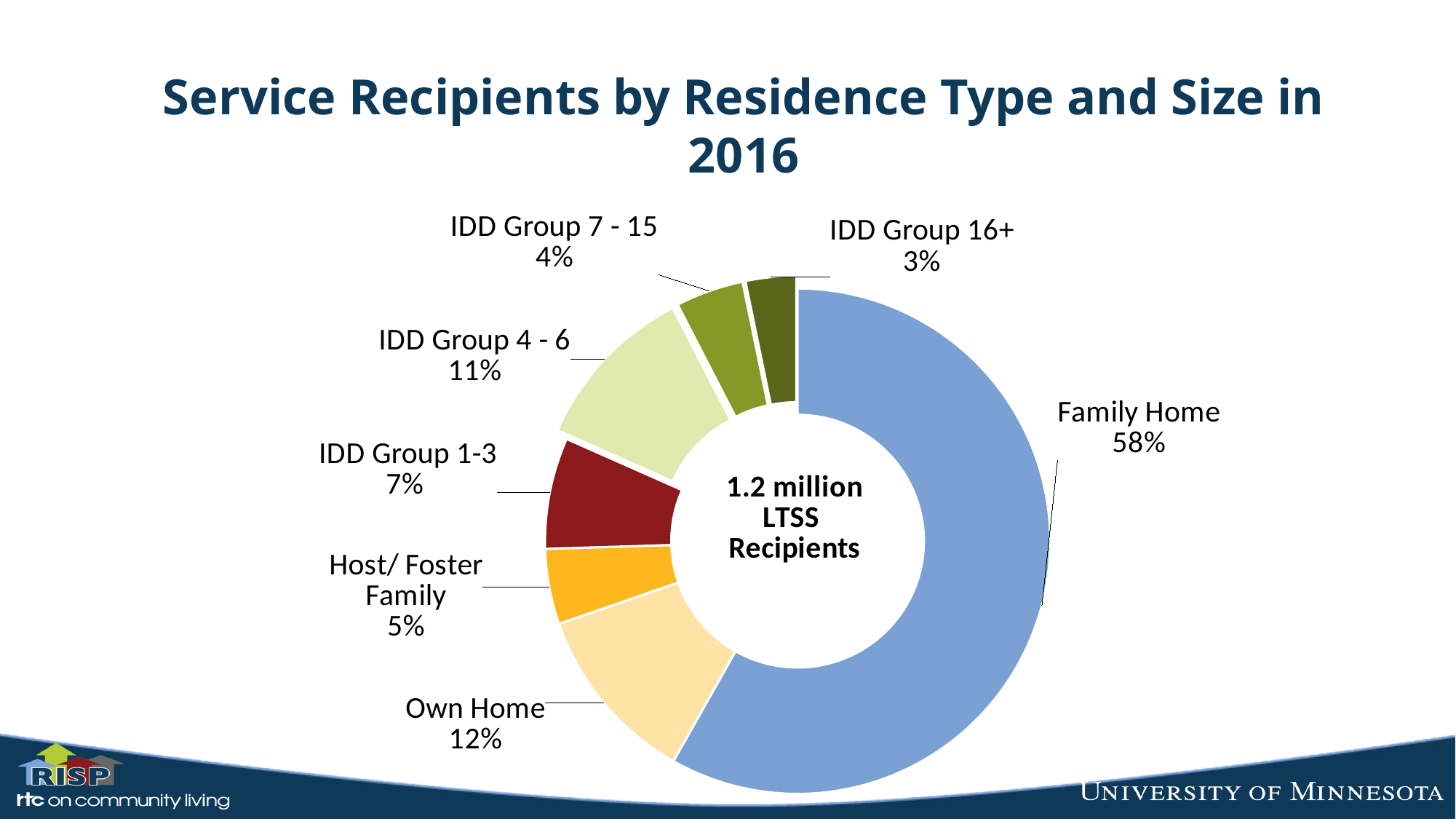
What kind of chart is shown on the slide? Pie chart (donut) What percentage of service recipients live in their Own Home? 12% What percentage of service recipients live with a Host/ Foster Family? 5% What is the difference in percentage points between IDD Group 4 - 6 and IDD Group 1-3? 4 What share of service recipients are in IDD Group 4 - 6 residences? 11% How many residence type categories are shown in the chart? 7 What text appears in the center of the chart? 1.2 million LTSS Recipients What share of service recipients live in a Family Home? 58% What is the difference in percentage points between Family Home and Own Home? 46 Which has a larger share, IDD Group 7 - 15 or Host/ Foster Family? Host/ Foster Family Which residence type has the smallest share of service recipients? IDD Group 16+ Which residence type has the largest share of service recipients? Family Home